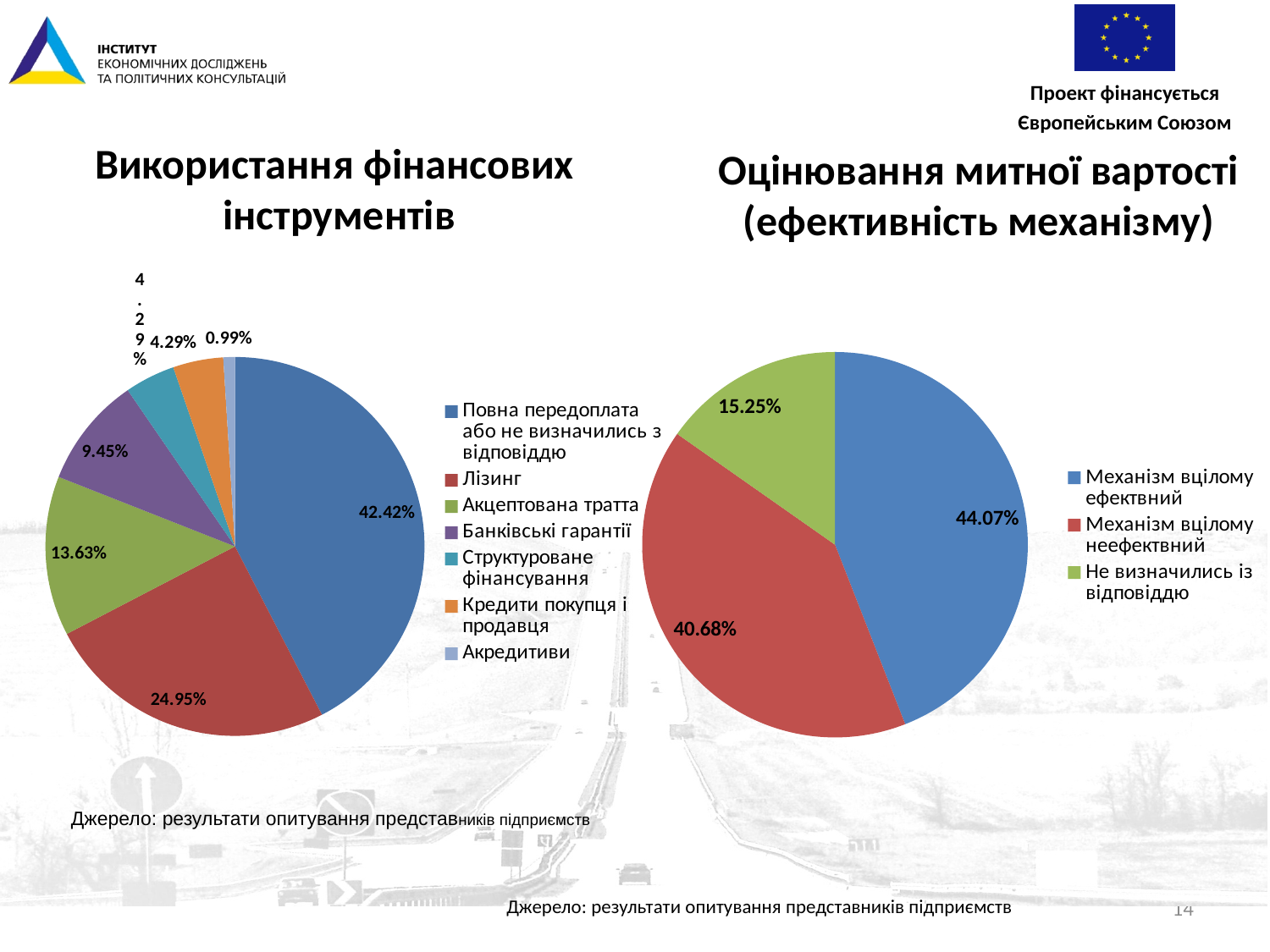
On the left chart 'Використання фінансових інструментів', which category has the smallest slice? Акредитиви On the left chart 'Використання фінансових інструментів', what is the value for Акцептована тратта? 13.63% On the right chart 'Оцінювання митної вартості', what is the value for Не визначились із відповіддю? 15.25% On the left chart 'Використання фінансових інструментів', what is the difference between Лізинг and Акцептована тратта? 11.32% On the right chart 'Оцінювання митної вартості', what is the difference between Механізм вцілому ефективний and Механізм вцілому неефективний? 3.39% On the left chart 'Використання фінансових інструментів', what is the value for Банківські гарантії? 9.45% On the right chart 'Оцінювання митної вартості', what is the value for Механізм вцілому неефективний? 40.68% On the left chart 'Використання фінансових інструментів', what is the value for Лізинг? 24.95% On the left chart 'Використання фінансових інструментів', which category has the largest slice? Повна передоплата або не визначились з відповіддю What type of chart is the right chart 'Оцінювання митної вартості'? Pie chart On the left chart 'Використання фінансових інструментів', how many categories does the legend list? 7 On the right chart 'Оцінювання митної вартості', which is larger: Механізм вцілому ефективний or Механізм вцілому неефективний? Механізм вцілому ефективний